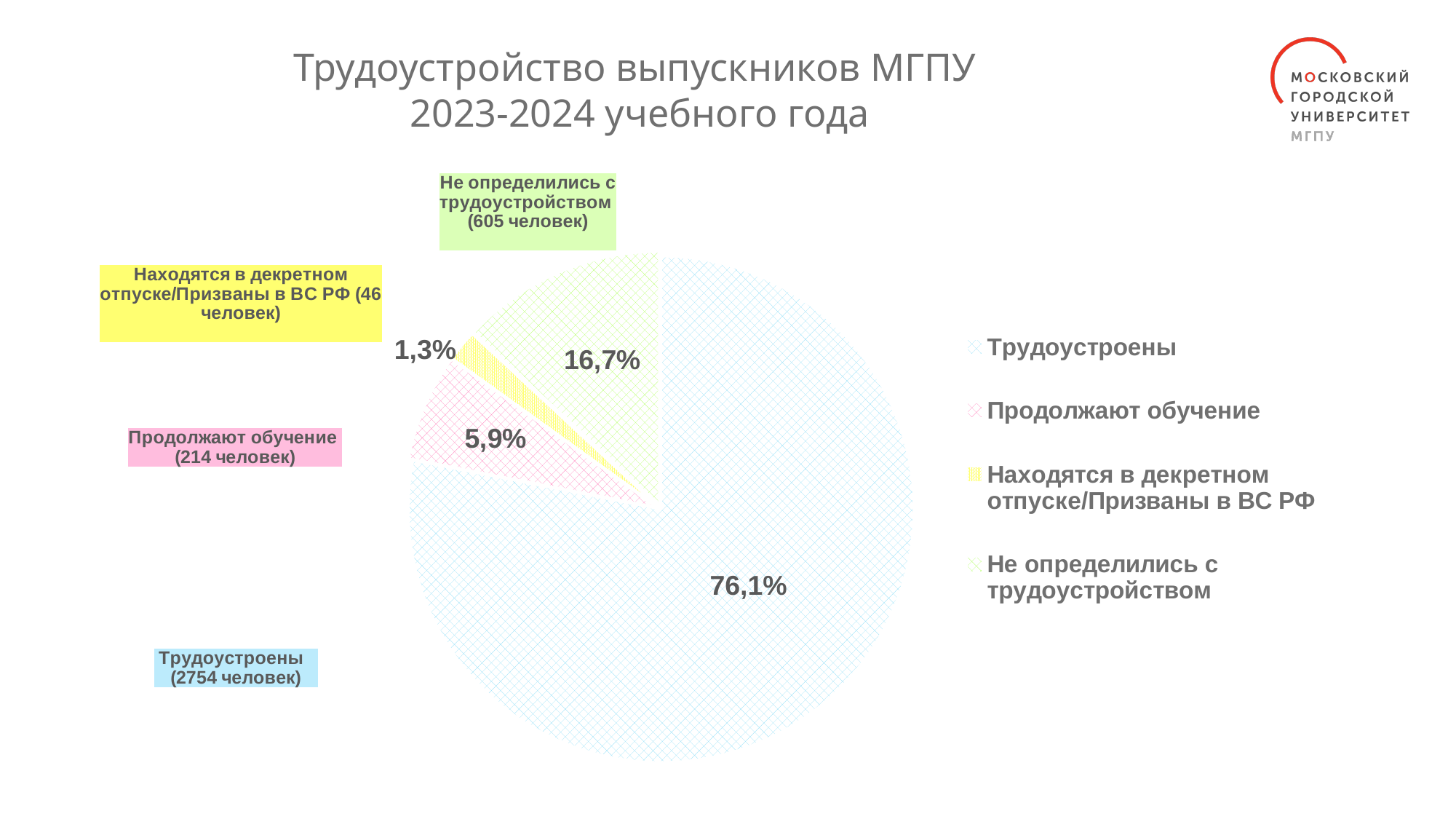
What percentage of graduates are shown as "Находятся в декретном отпуске/Призваны в ВС РФ"? 1,3% What percentage of graduates are shown as "Трудоустроены"? 76,1% What is the difference in percentage points between "Трудоустроены" and "Не определились с трудоустройством"? 59,4% What percentage of graduates are shown as "Не определились с трудоустройством"? 16,7% Which category has the smallest share of the pie? Находятся в декретном отпуске/Призваны в ВС РФ How many people are in the "Продолжают обучение" category according to the label on the slide? 214 человек Which category has the largest share of the pie? Трудоустроены How many categories does the legend of the pie chart list? 4 What kind of chart is shown on the slide? Pie chart Which is larger: the share for "Продолжают обучение" or the share for "Не определились с трудоустройством"? Не определились с трудоустройством How many people are in the "Трудоустроены" category according to the label on the slide? 2754 человек What percentage of graduates are shown as "Продолжают обучение"? 5,9%